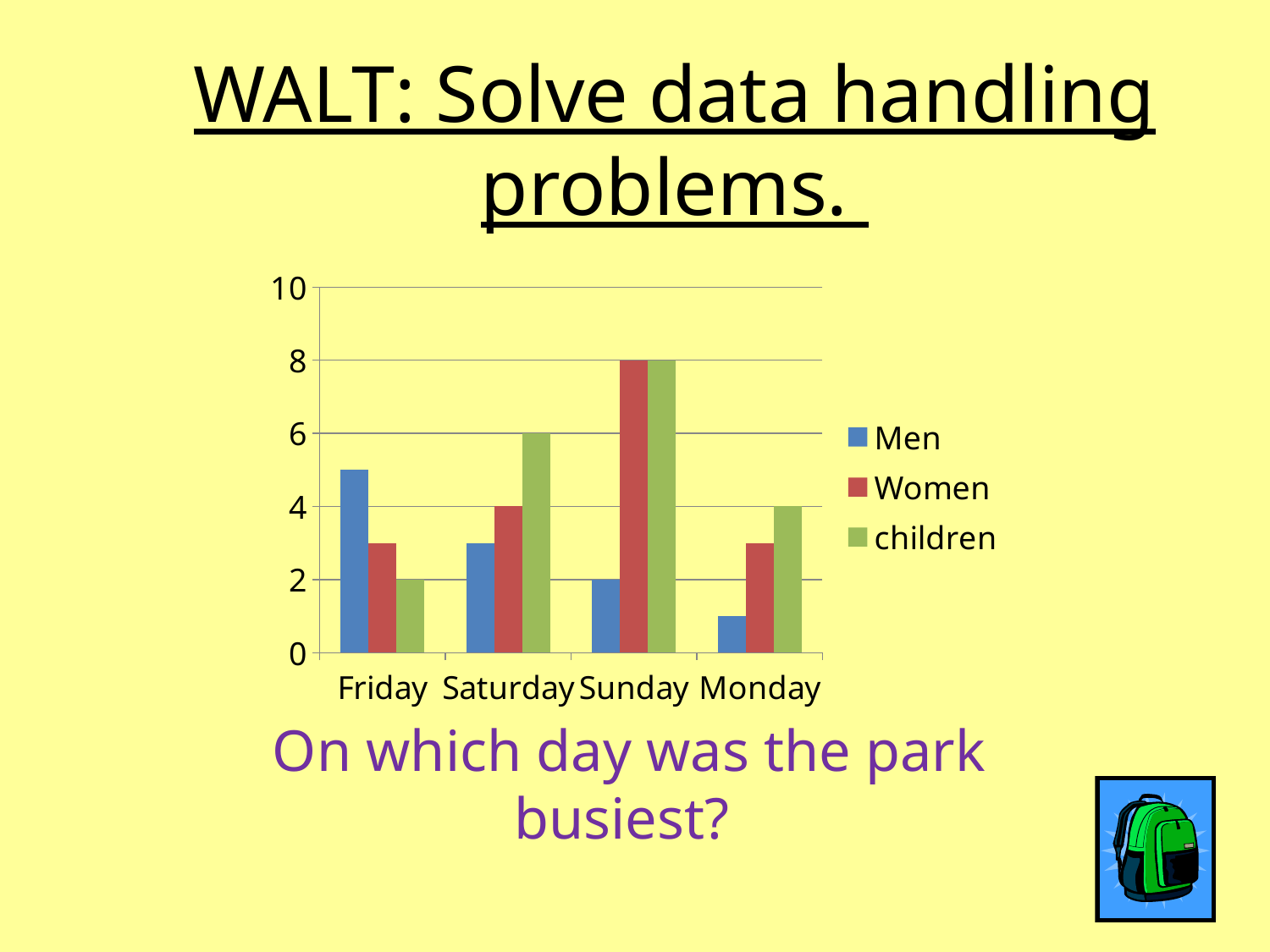
How many days are shown on the x axis? 4 How many series does the legend list? 3 What is the value for Men on Sunday? 2 What is the value for children on Monday? 4 On which day is the children series lowest? Friday Is the value for Men on Friday greater or less than 4? greater What is the value for children on Saturday? 6 What kind of chart is shown on the slide? bar chart What is the value for Women on Sunday? 8 Which is larger on Friday, the Men value or the Women value? Men On which day is the Men series highest? Friday What is the difference between the Women and Men values on Sunday? 6